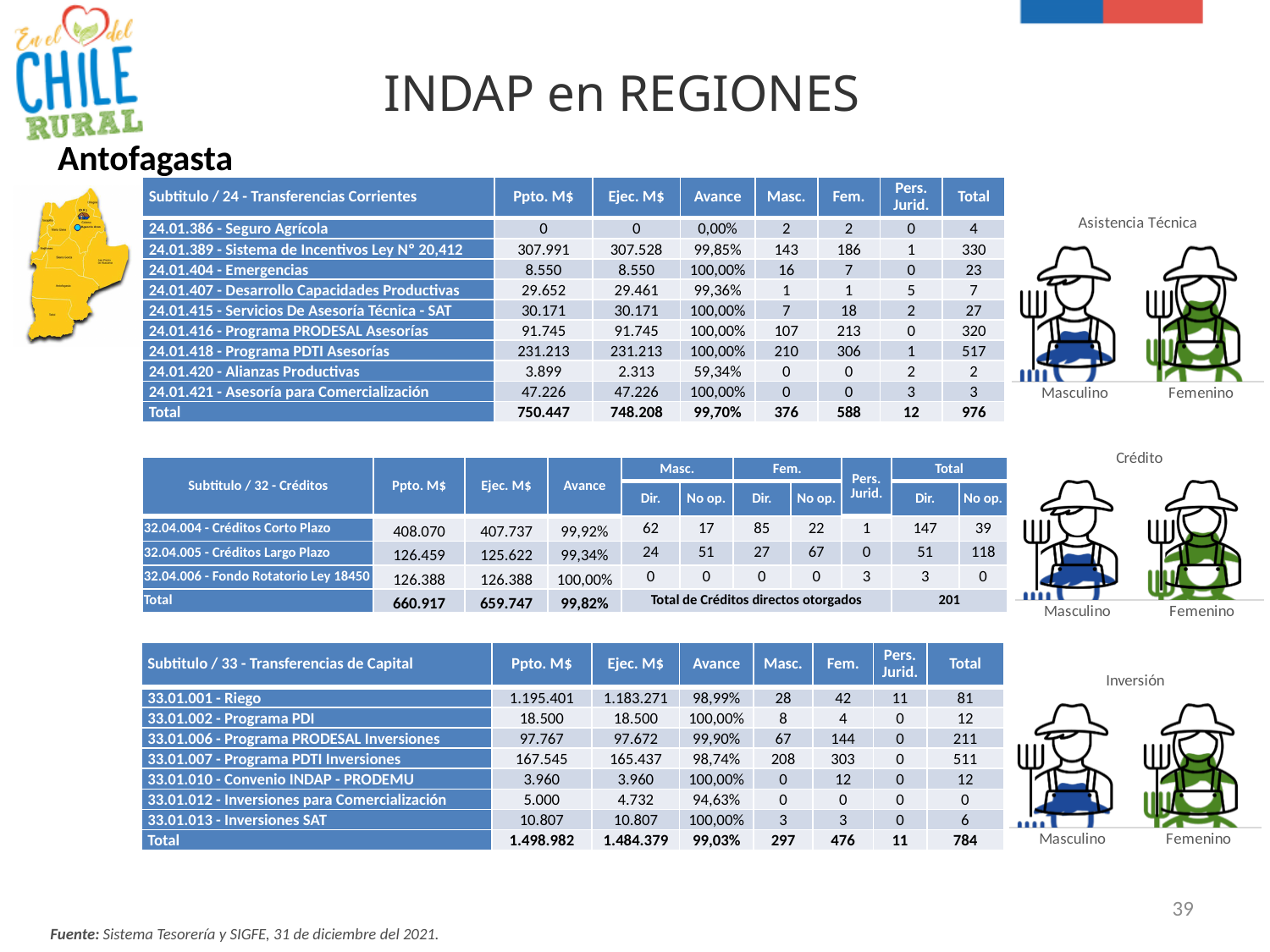
In the "Crédito" pictograph chart, how many categories are shown? 2 What are the titles of the three pictograph charts on the right of the slide? Asistencia Técnica, Crédito, Inversión In the "Inversión" pictograph chart, which category has the larger filled share, Masculino or Femenino? Femenino In the "Asistencia Técnica" pictograph chart, which category has the larger filled share, Masculino or Femenino? Femenino What kind of chart is used under the heading "Asistencia Técnica" on the right of the slide? pictograph (filled farmer icons) In the "Inversión" pictograph chart, which colour is used for the Masculino icon fill? blue In the "Asistencia Técnica" pictograph chart, which colour is used for the Femenino icon fill? green In the "Crédito" pictograph chart, which category has the larger filled share, Masculino or Femenino? Femenino How many pictograph charts are shown on the right side of the slide? 3